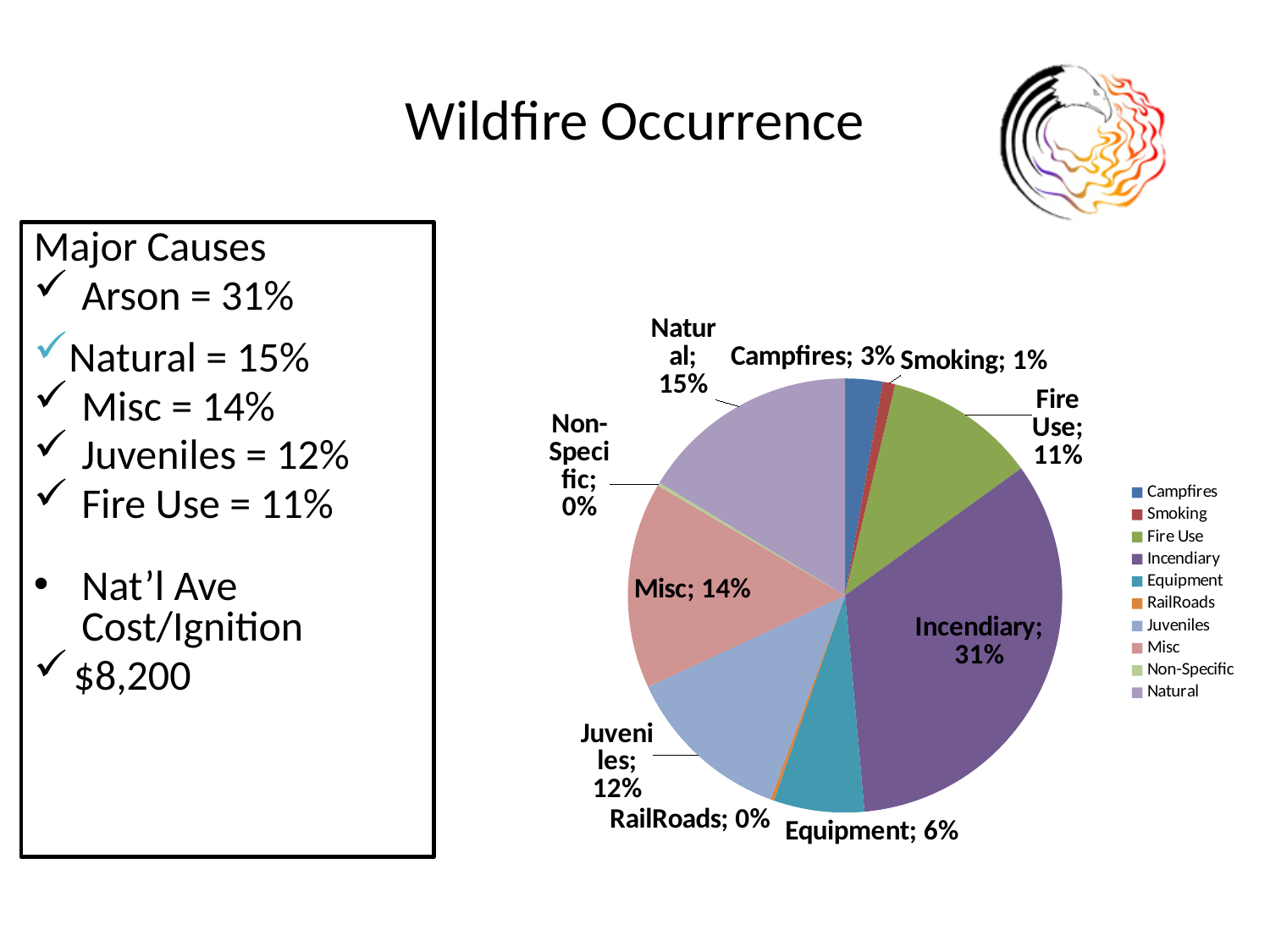
What is the value shown for RailRoads? 0% What is the value shown for Equipment? 6% What share of the pie does Incendiary account for? 31% What is the value shown for Fire Use? 11% Which is larger, the Campfires slice or the Smoking slice? Campfires What kind of chart is shown on the slide? pie chart What colour is the Incendiary slice in the pie chart? purple Which category has the largest slice of the pie? Incendiary How many slices are labelled in the pie chart? 10 How many categories does the legend list? 10 What is the difference between the Misc and Juveniles percentages? 2% What is the value shown for Natural? 15%